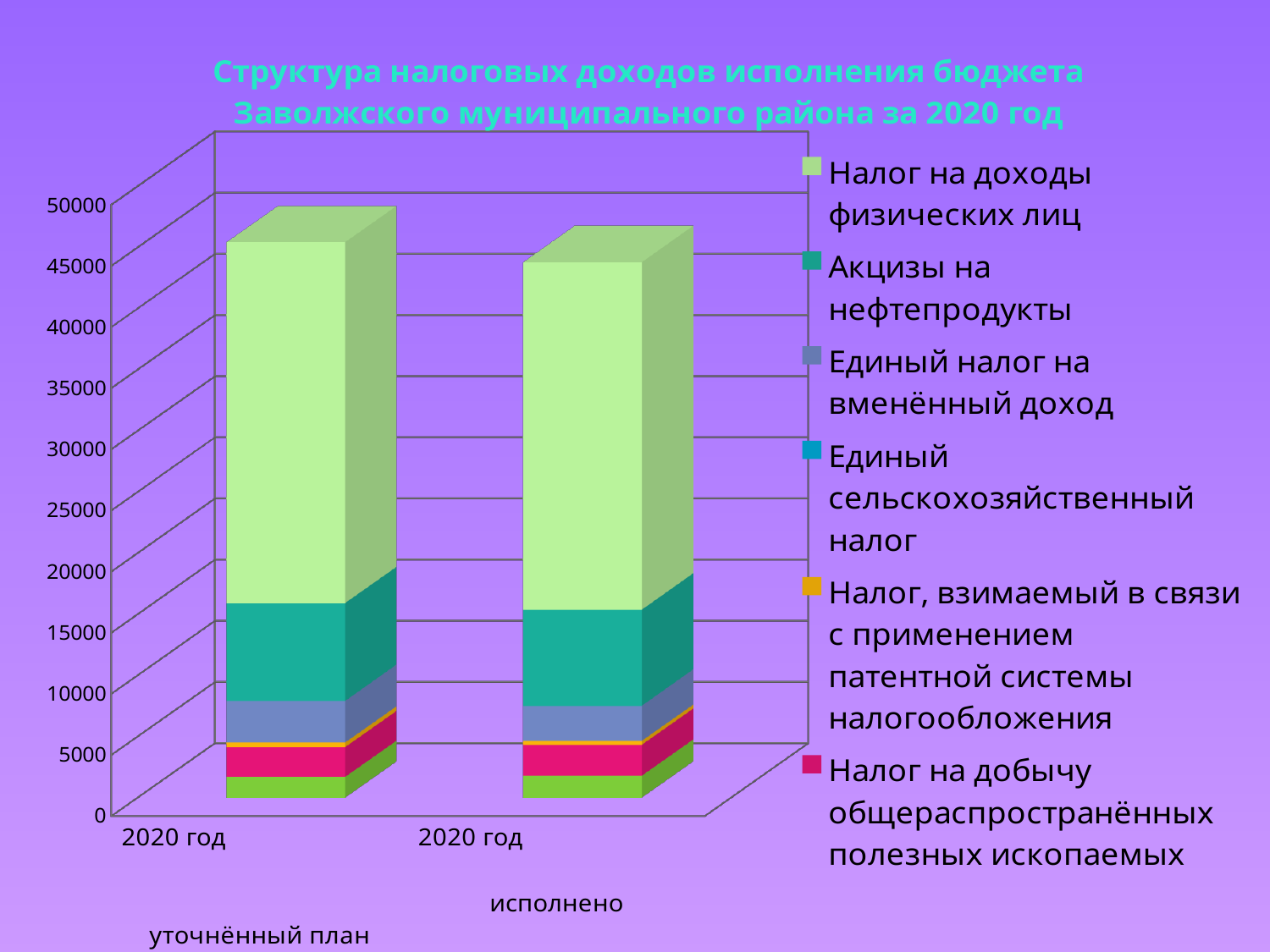
Does the total fall or rise from уточнённый план to исполнено? fall Is the total of the уточнённый план bar greater or less than 40000? greater Which bar is taller, уточнённый план or исполнено? уточнённый план Is the total of the исполнено bar greater or less than 50000? less How many series does the legend list? 6 How many bars are plotted in the chart? 2 Is the total of the исполнено bar greater or less than 40000? greater What kind of chart is shown on the slide? stacked bar chart What is the title of the chart? Структура налоговых доходов исполнения бюджета Заволжского муниципального района за 2020 год What is the second entry in the legend? Акцизы на нефтепродукты Which series forms the largest segment in each bar? Налог на доходы физических лиц